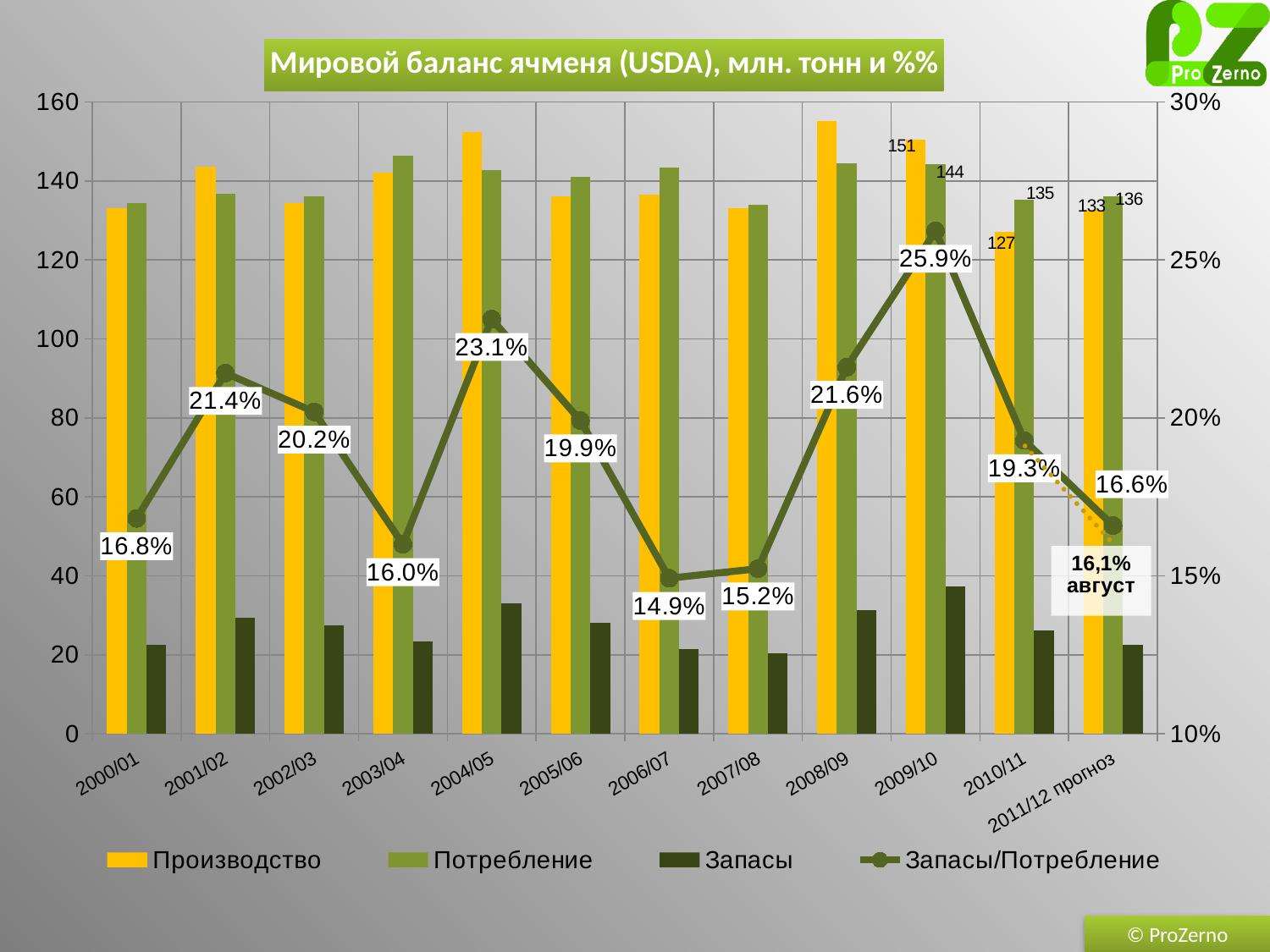
What is the Запасы/Потребление value for 2009/10? 25.9% In which season is the Запасы/Потребление ratio lowest? 2006/07 What is the Производство value for 2010/11? 127 How many series does the legend list? 4 Is the Производство value for 2004/05 greater or less than 140? greater Does the Запасы/Потребление line rise or fall from 2009/10 to 2011/12 прогноз? fall How many seasons are shown on the x axis? 12 In which season is the Запасы/Потребление ratio highest? 2009/10 What is the Запасы/Потребление value for 2006/07? 14.9% What is the difference between Производство and Потребление in 2009/10? 7 In 2010/11, which is larger: Производство or Потребление? Потребление What is the Потребление value for 2011/12 прогноз? 136